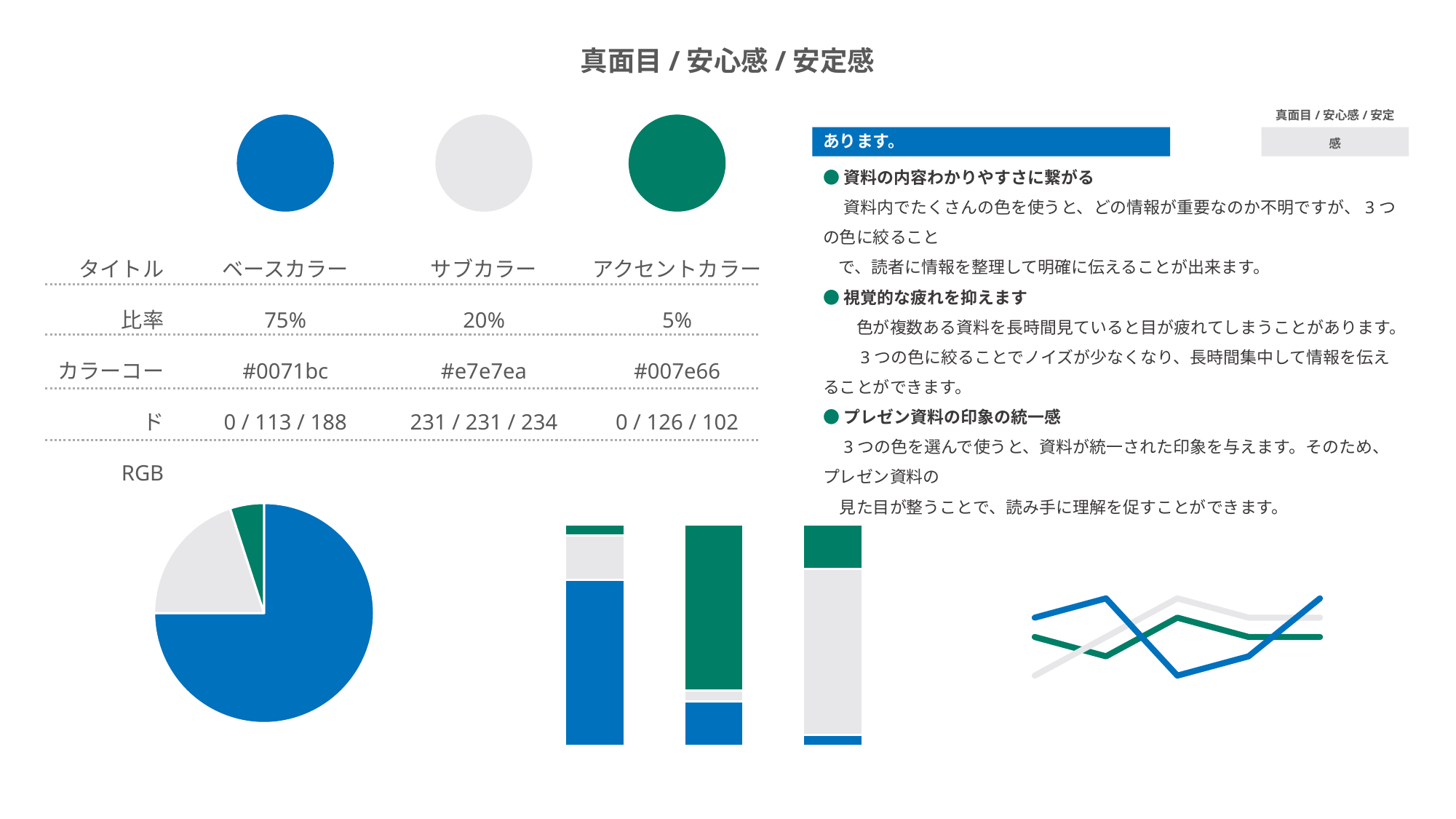
What three colours are used across the charts on the slide? blue, grey and green What kind of chart is shown in the bottom centre of the slide? stacked bar chart What kind of chart is shown at the bottom right of the slide? line chart In the pie chart at the bottom left, is the grey slice larger or smaller than the green slice? larger How many lines are plotted in the line chart at the bottom right? 3 In the pie chart at the bottom left, which colour slice is the smallest? green How many segments does each bar in the stacked bar chart in the bottom centre have? 3 How many bars are in the stacked bar chart in the bottom centre? 3 What kind of chart is shown at the bottom left of the slide? pie chart In the pie chart at the bottom left, which colour slice is the largest? blue How many slices does the pie chart at the bottom left have? 3 In the stacked bar chart in the bottom centre, which colour segment is the largest in the left bar? blue